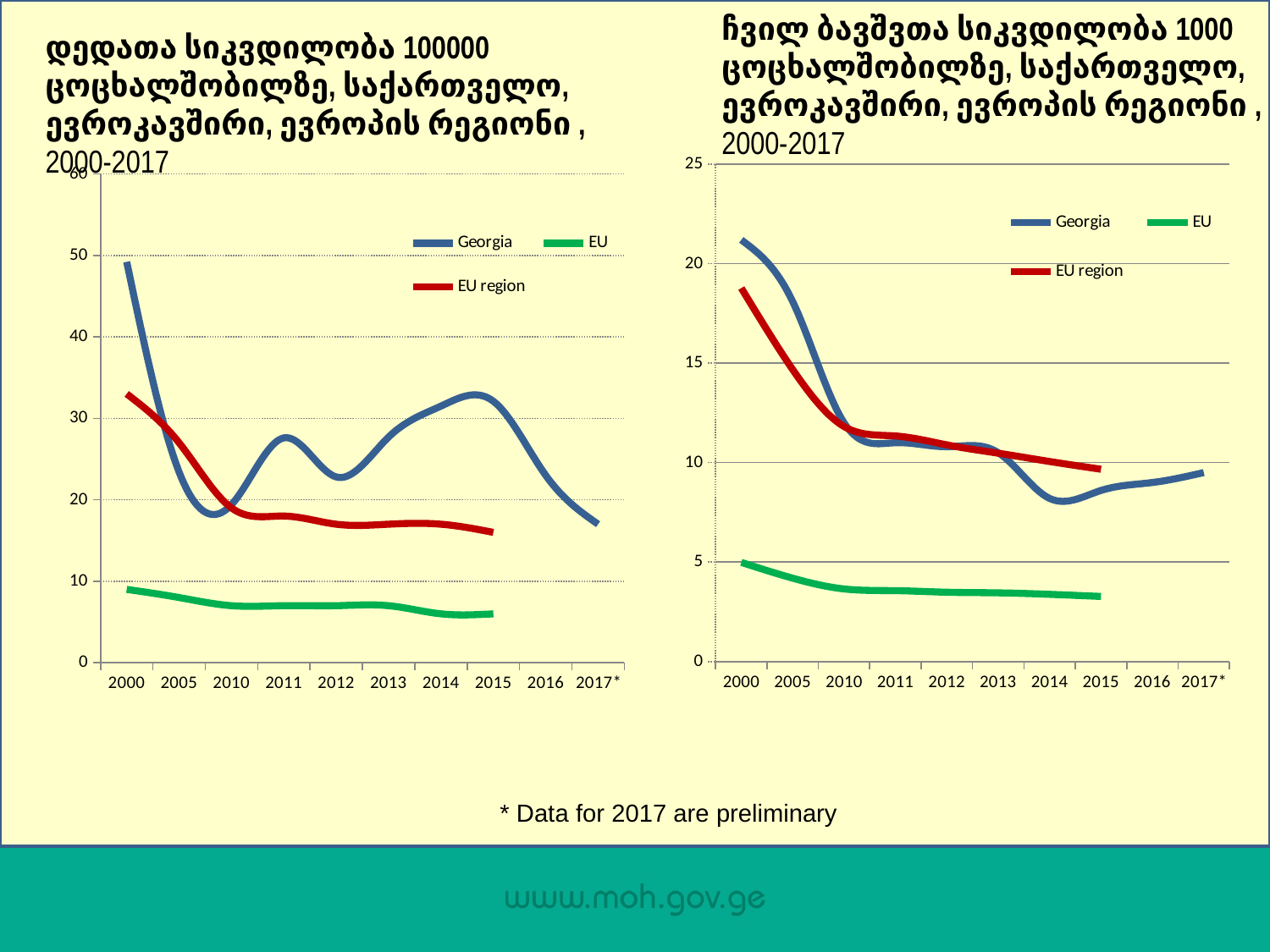
What kind of chart is the left chart on the slide? line chart In the right chart, which is larger in 2015, EU region or EU? EU region In the left chart, is the value for EU in 2000 greater or less than 10? less In the right chart, does the EU line rise or fall from 2000 to 2015? fall In the right chart, is the value for EU in 2015 greater or less than 5? less In the left chart, which series has the lowest value in 2015? EU How many years are labelled on the x axis of the left chart? 10 In the left chart, is the value for Georgia in 2000 greater or less than 40? greater In the left chart, which series has the highest value in 2000? Georgia How many series does the legend of the right chart list? 3